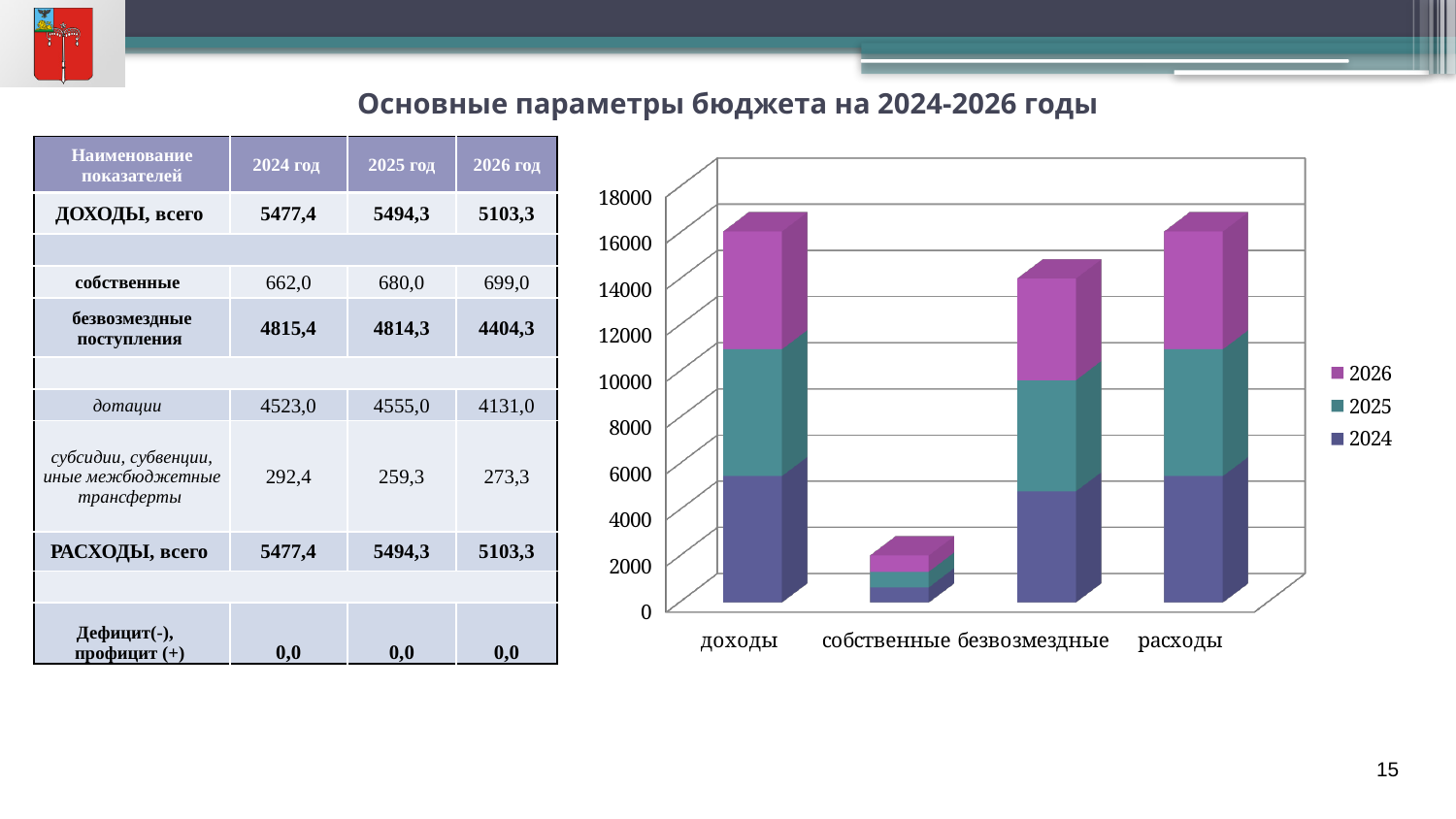
What are the entries listed in the chart legend? 2026, 2025, 2024 Is the total of the stacked bar for расходы greater or less than 14000? greater What kind of chart is shown on the slide? stacked bar chart Is the stacked bar for доходы taller or shorter than the stacked bar for собственные? taller Is the total of the stacked bar for собственные greater or less than 4000? less Which category has the lowest stacked bar in the chart? собственные Is the stacked bar for безвозмездные taller or shorter than the stacked bar for доходы? shorter Is the total of the stacked bar for безвозмездные greater or less than 12000? greater Which series is shown at the bottom of each stacked bar? 2024 How many series does the chart legend list? 3 How many categories are shown on the x axis of the chart? 4